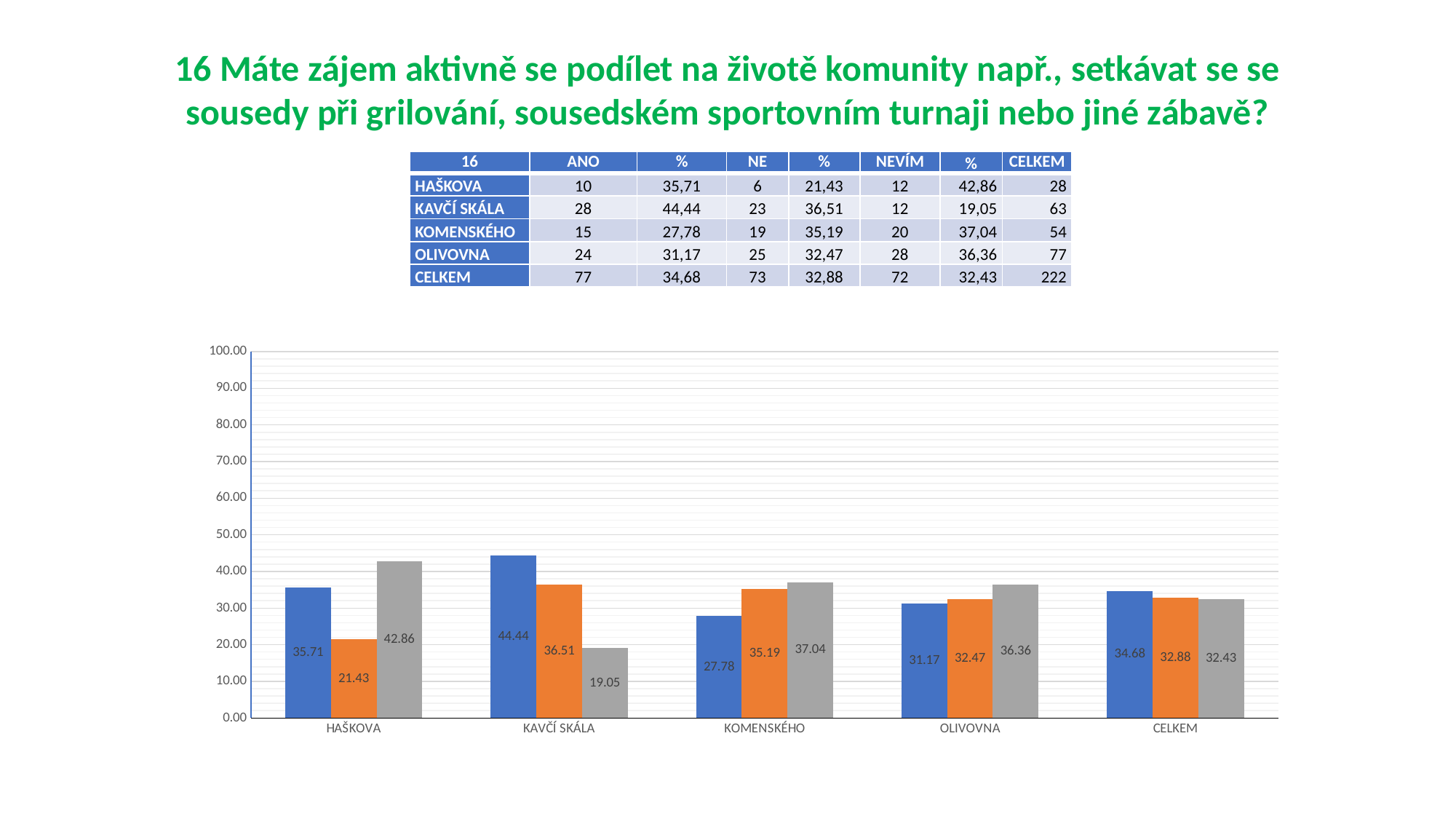
Which category has the highest blue bar? KAVČÍ SKÁLA What is the difference between the grey bar and the orange bar for HAŠKOVA? 21.43 What kind of chart is shown on the slide? bar chart What is the value of the grey bar for HAŠKOVA? 42.86 What is the value of the orange bar for KOMENSKÉHO? 35.19 What is the difference between the blue bar and the grey bar for KAVČÍ SKÁLA? 25.39 How many categories are shown on the x axis of the chart? 5 Which category has the lowest orange bar? HAŠKOVA What is the value of the blue bar for KAVČÍ SKÁLA? 44.44 Which category has the lowest grey bar? KAVČÍ SKÁLA For OLIVOVNA, which is larger: the blue bar or the grey bar? the grey bar Is the value of the blue bar for KAVČÍ SKÁLA greater or less than 40? greater